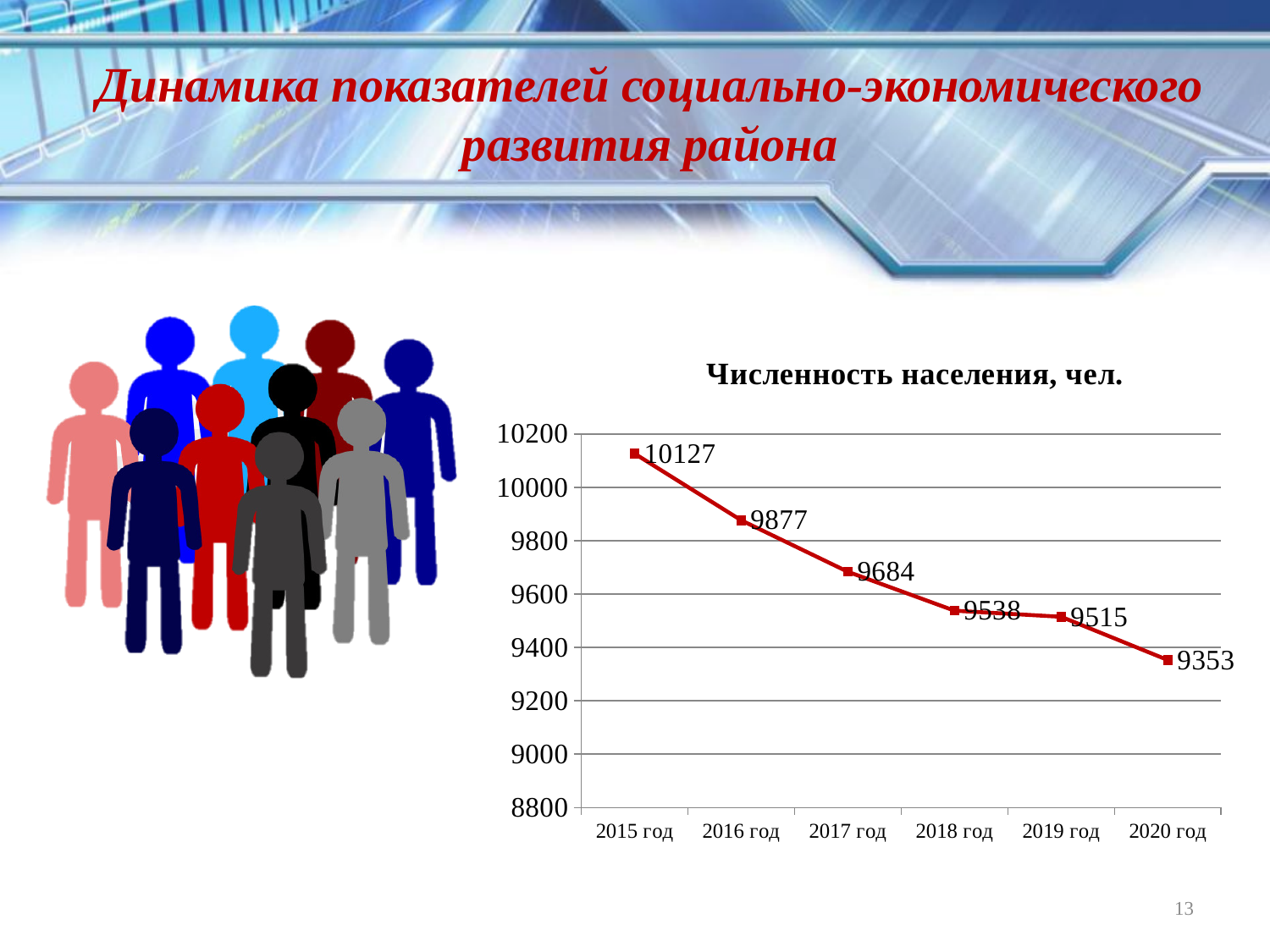
What is the difference between the population values for 2015 год and 2020 год? 774 What is the population value for 2015 год? 10127 Which is larger, the population value for 2018 год or for 2019 год? 2018 год Does the population rise or fall from 2015 год to 2020 год? fall What is the difference between the population values for 2016 год and 2017 год? 193 Which year has the highest population value? 2015 год How many years are plotted on the chart? 6 Is the population value for 2016 год greater or less than 9800? greater What kind of chart is shown on the slide? line chart What is the population value for 2017 год? 9684 Which year has the lowest population value? 2020 год What is the population value for 2020 год? 9353